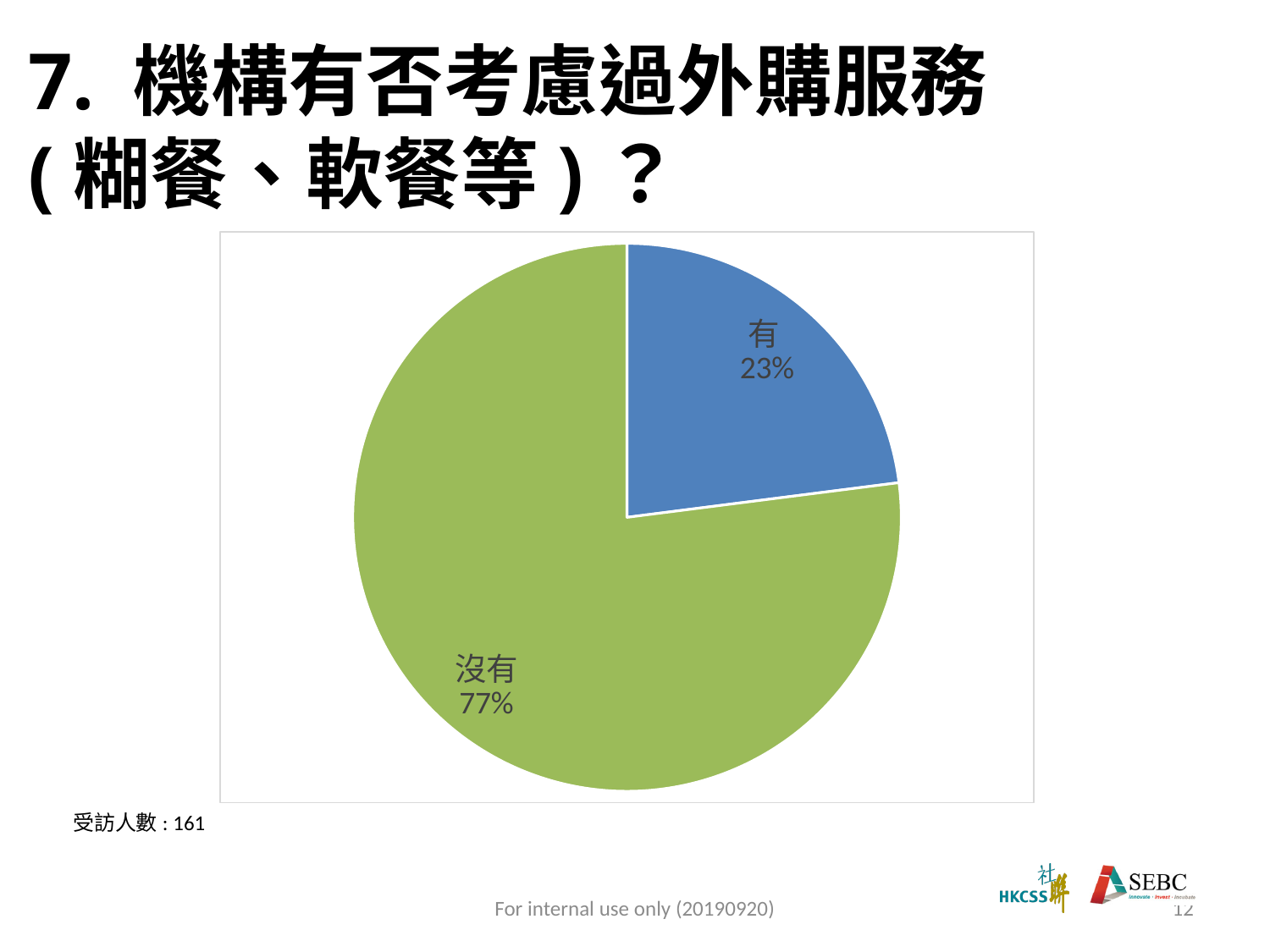
What colour is the 沒有 slice? green How many slices does the pie chart have? 2 What is the total of the two slice percentages shown? 100% What share of the pie is labelled 沒有? 77% What share of the pie is labelled 有? 23% What is the difference in percentage points between the 沒有 slice and the 有 slice? 54 What kind of chart is shown on the slide? pie chart Which slice of the pie is the largest? 沒有 How many respondents (受訪人數) are stated below the chart? 161 Which slice of the pie is the smallest? 有 Which is larger, the 有 slice or the 沒有 slice? 沒有 What colour is the 有 slice? blue